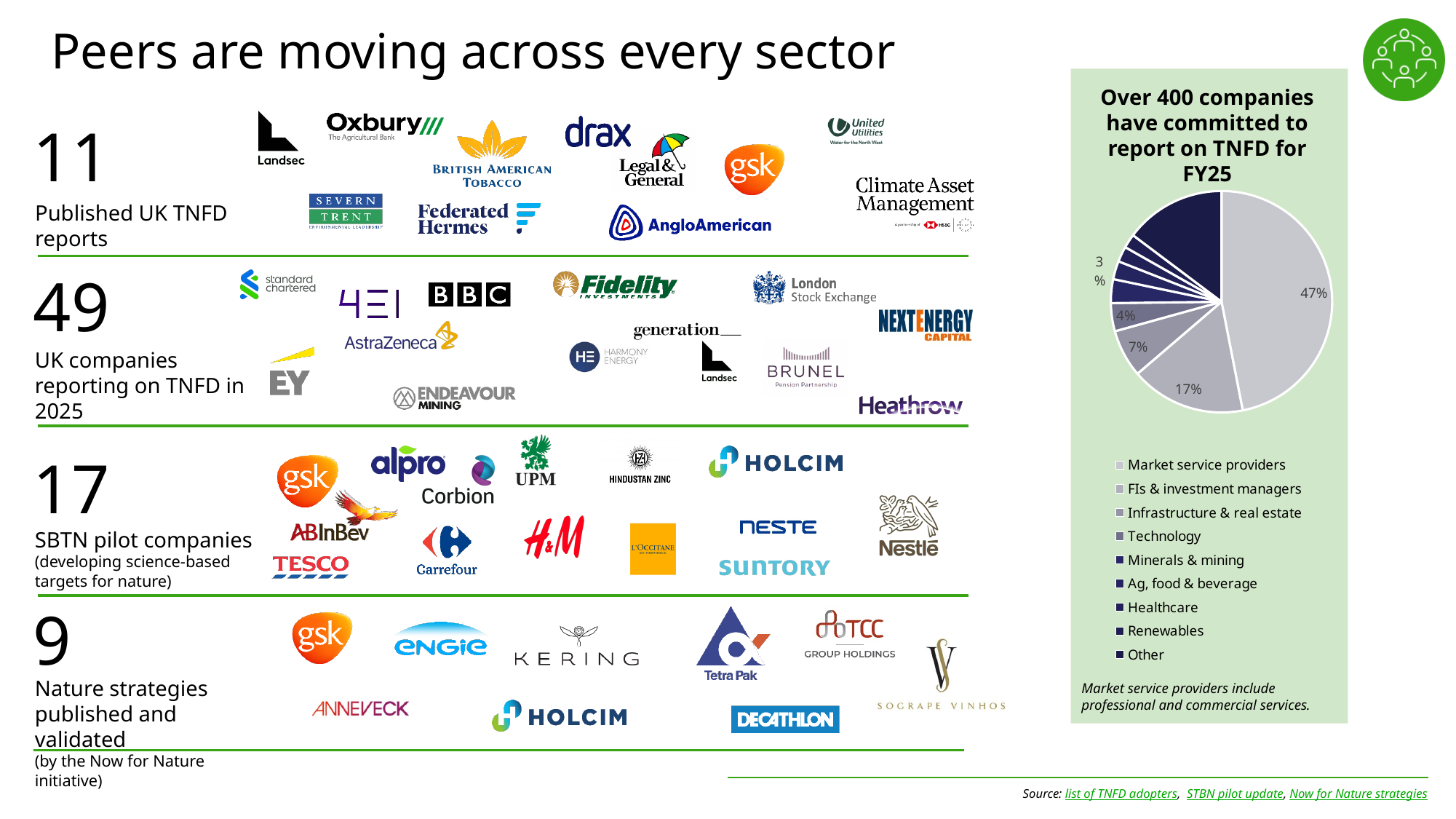
What kind of chart is shown on the slide? Pie chart Which legend entry is listed last in the pie chart's legend? Other Is the share for Market service providers greater or less than 40%? greater What share of the pie do Market service providers account for? 47% What share of the pie do FIs & investment managers account for? 17% How many categories does the pie chart's legend list? 9 What is the difference in percentage points between the Market service providers slice and the FIs & investment managers slice? 30 percentage points What share of the pie does Technology account for? 4% Which slice is larger: FIs & investment managers or Infrastructure & real estate? FIs & investment managers What is the title of the pie chart? Over 400 companies have committed to report on TNFD for FY25 Which category has the largest share of the pie chart? Market service providers